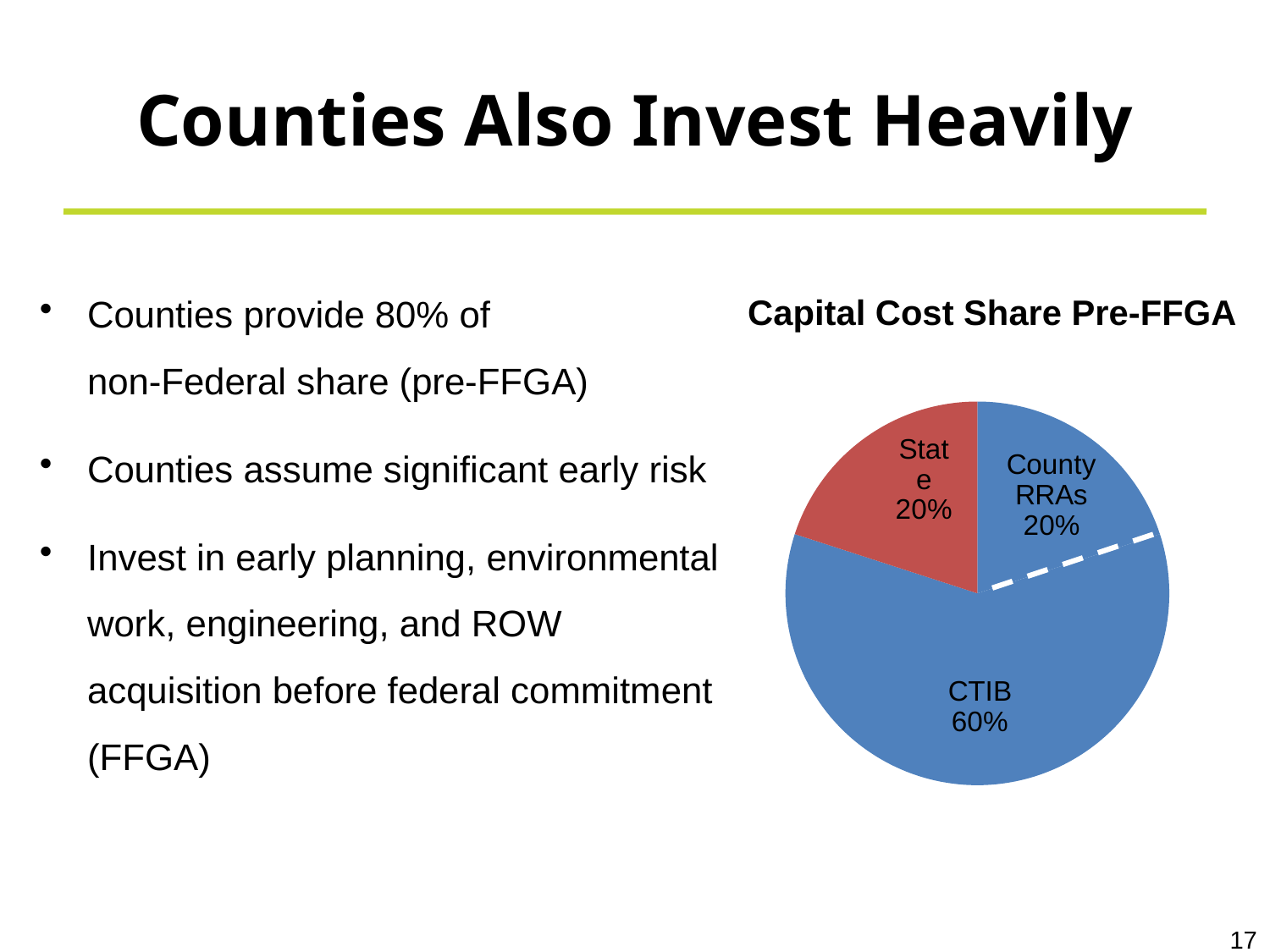
What kind of chart is shown on the slide? pie chart What share of the pie does CTIB hold? 60% Which slice of the pie is the largest? CTIB What is the title of the chart? Capital Cost Share Pre-FFGA What share of the pie does State hold? 20% What is the difference between the CTIB share and the State share? 40% Which is larger, the CTIB share or the County RRAs share? CTIB What is the combined share of CTIB and County RRAs? 80% What share of the pie do County RRAs hold? 20% Which slice of the pie is shown in red? State How many slices does the pie chart have? 3